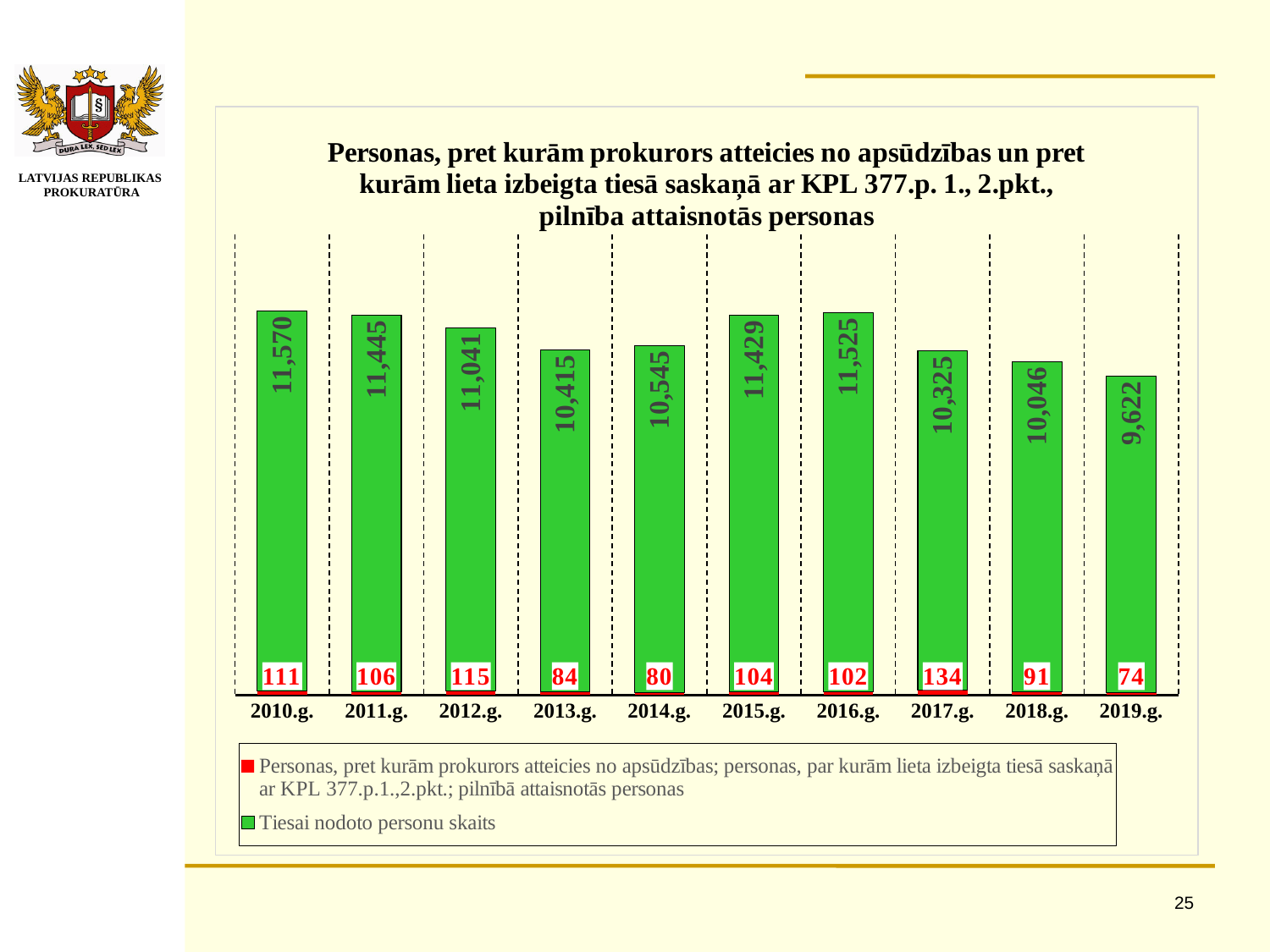
What is the value of "Tiesai nodoto personu skaits" for 2019.g.? 9,622 Which year has the highest value for "Tiesai nodoto personu skaits"? 2010.g. Which year has the lowest value for the red series (Personas, pret kurām prokurors atteicies no apsūdzības...)? 2019.g. Which colour represents "Tiesai nodoto personu skaits" in the legend? Green How many years are shown on the x axis? 10 What kind of chart is shown on the slide? Stacked bar chart What is the difference between the "Tiesai nodoto personu skaits" values for 2010.g. and 2019.g.? 1,948 What is the value of "Tiesai nodoto personu skaits" for 2010.g.? 11,570 What is the value of the red series (Personas, pret kurām prokurors atteicies no apsūdzības...) for 2017.g.? 134 How many series does the legend list? 2 Which is larger: the "Tiesai nodoto personu skaits" value for 2015.g. or for 2016.g.? 2016.g. What is the total of the stacked bar for 2019.g.? 9,696